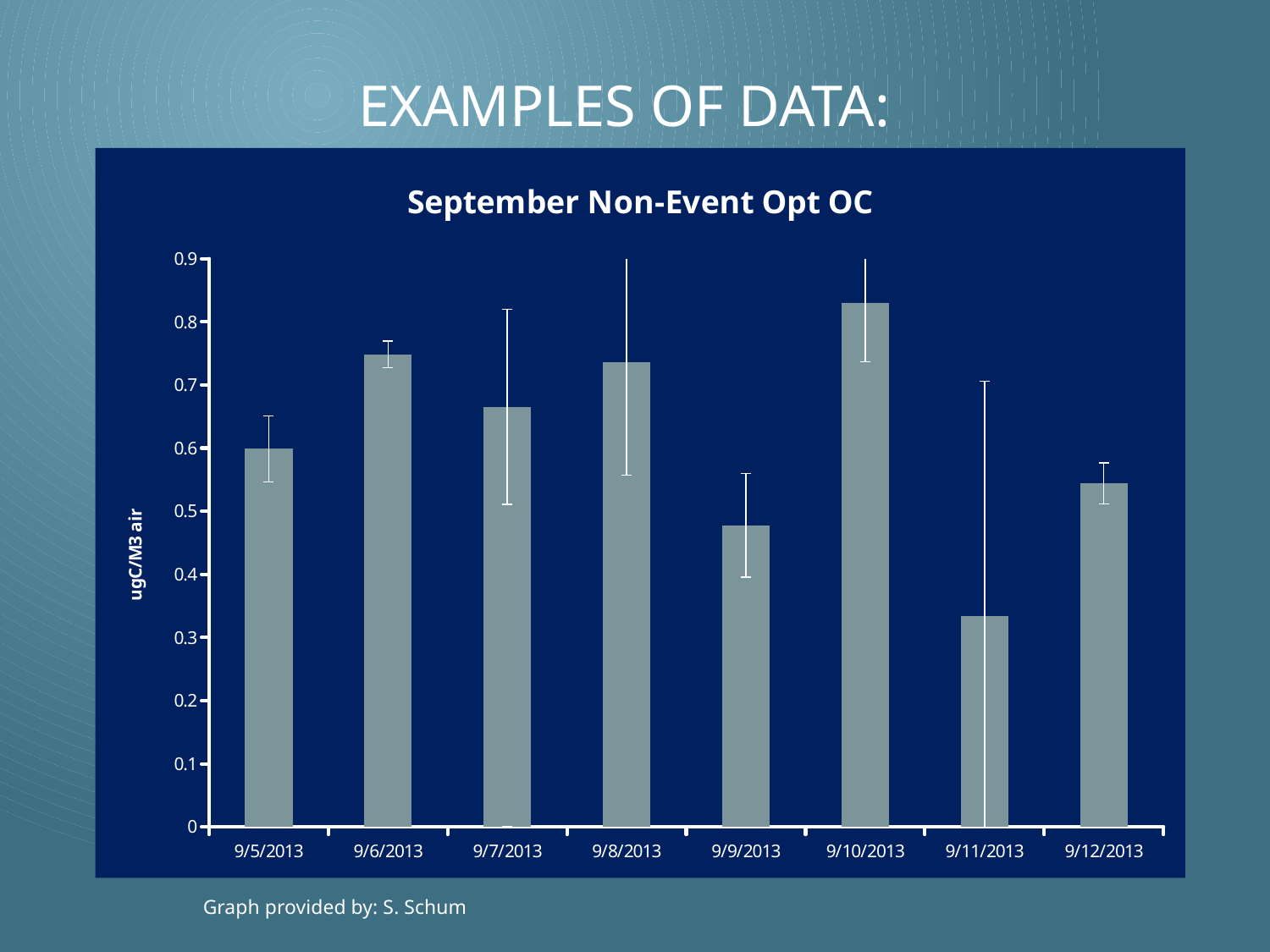
How many dates are plotted on the x axis of the chart? 8 Is the value for 9/10/2013 greater or less than 0.8? greater What is the title of the chart? September Non-Event Opt OC What is the label on the vertical axis of the chart? ugC/M3 air Which has the larger value, 9/6/2013 or 9/9/2013? 9/6/2013 Which date has the highest value in the chart? 9/10/2013 Is the value for 9/11/2013 greater or less than 0.4? less Is the value for 9/9/2013 greater or less than 0.5? less Which has the larger value, 9/12/2013 or 9/11/2013? 9/12/2013 Which date has the lowest value in the chart? 9/11/2013 Does the value rise or fall from 9/9/2013 to 9/10/2013? rise What type of chart is shown on the slide? bar chart